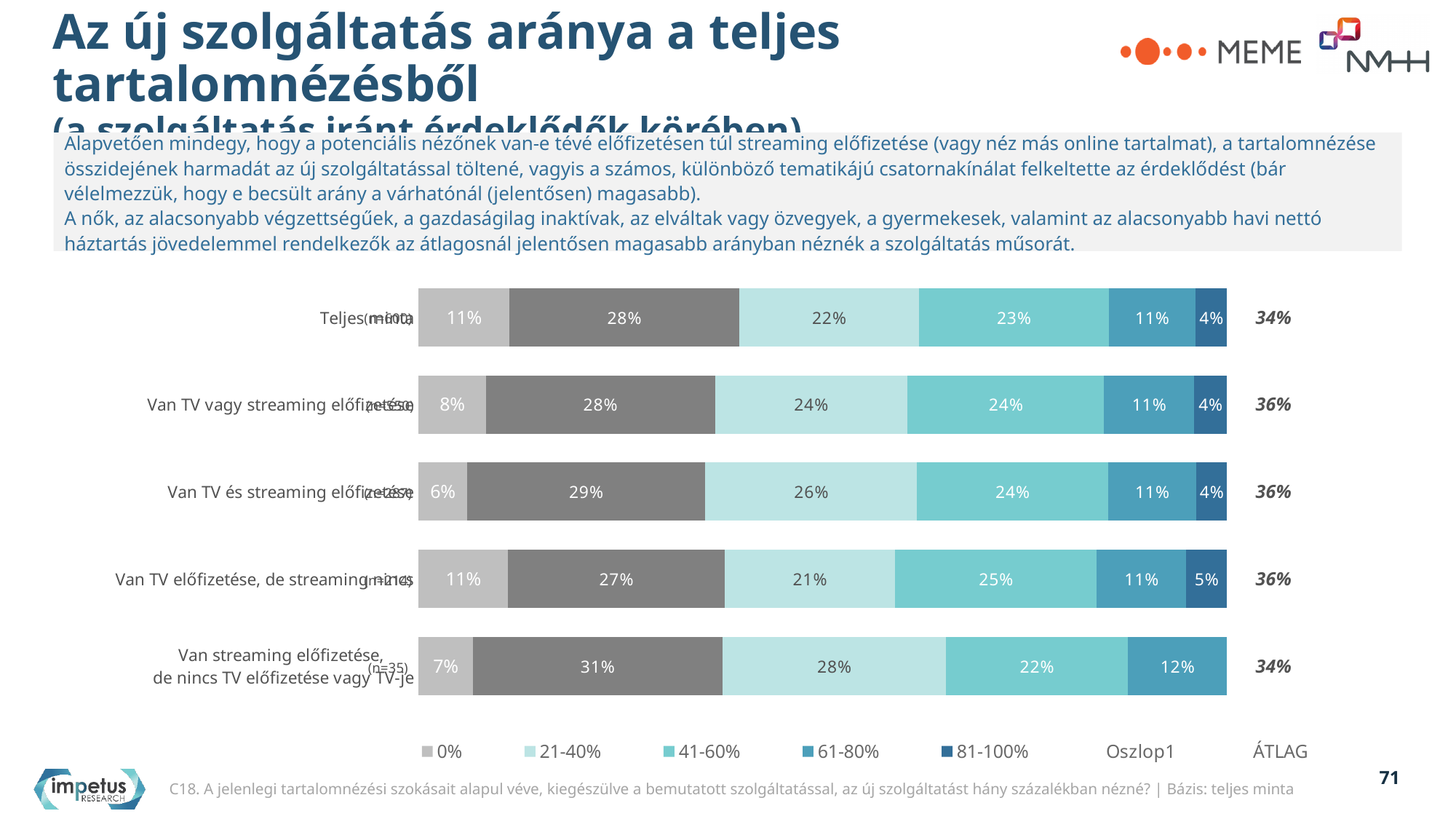
In the '41-60%' segment, which is larger: 'Teljes' or 'Van TV előfizetése, de streaming nincs'? Van TV előfizetése, de streaming nincs Which category has the lowest value in the '0%' segment? Van TV és streaming előfizetése What is the value of the '81-100%' segment for 'Van TV előfizetése, de streaming nincs'? 5% How many entries does the chart legend list? 7 What kind of chart is shown on the slide? stacked bar chart What is the ÁTLAG value shown for the 'Teljes' row? 34% What is the ÁTLAG value shown for the 'Van TV és streaming előfizetése' row? 36% Which category has the highest value in the '21-40%' segment? Van streaming előfizetése, de nincs TV előfizetése vagy TV-je What is the value of the '21-40%' segment for 'Van streaming előfizetése, de nincs TV előfizetése vagy TV-je'? 28% How many categories (rows) does the chart show? 5 What is the difference between the '21-40%' segment values of 'Van streaming előfizetése, de nincs TV előfizetése vagy TV-je' (28%) and 'Teljes' (22%)? 6 percentage points What is the value of the '0%' segment for 'Van TV és streaming előfizetése'? 6%